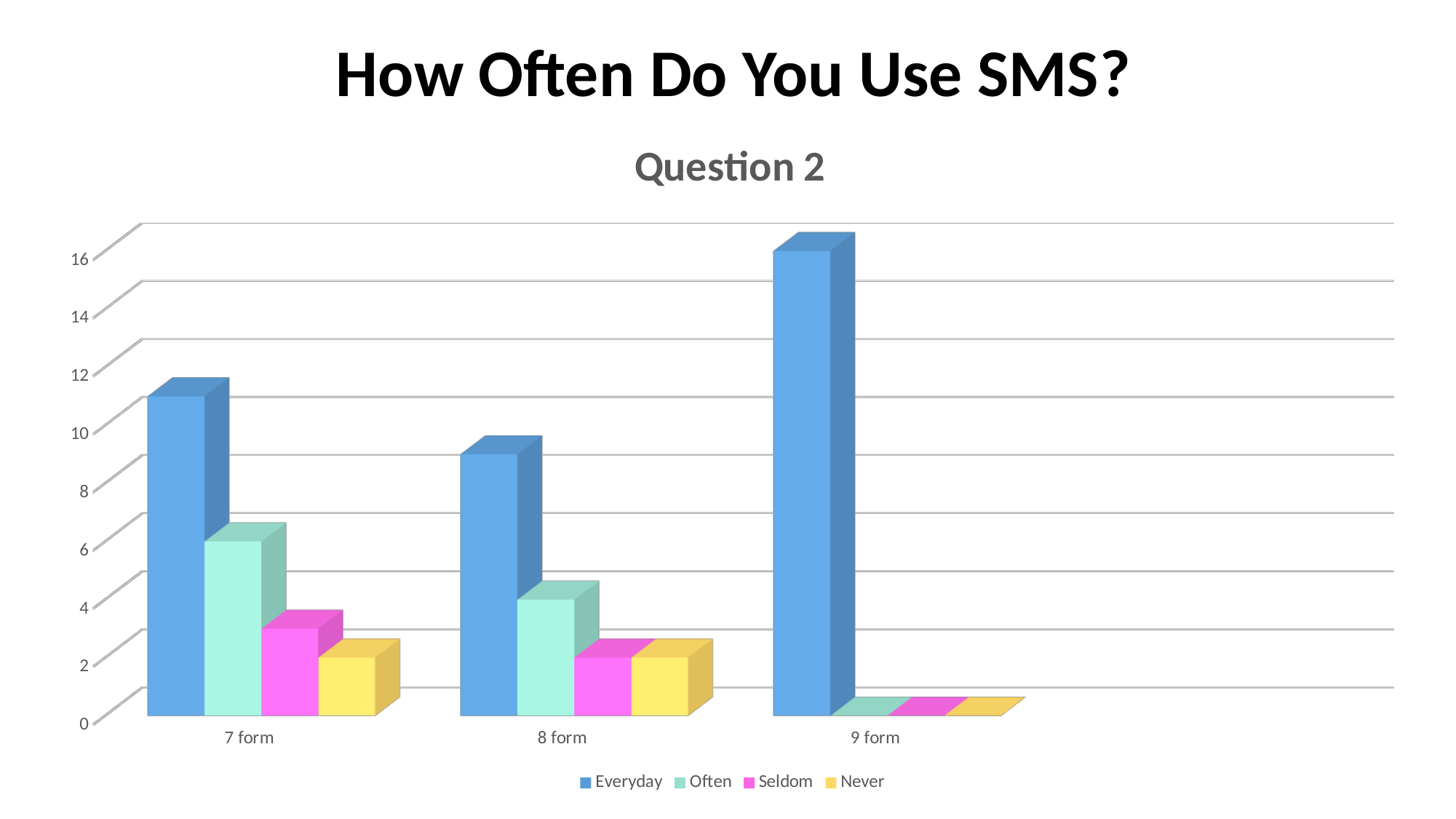
Is the Often value for 8 form greater or less than 6? less Which is larger, the Often value for 7 form or the Often value for 8 form? 7 form What is the title of the chart? Question 2 Which is larger, the Everyday value for 7 form or the Everyday value for 8 form? 7 form Is the Everyday value for 9 form greater or less than 14? greater Which category has the lowest Everyday value? 8 form Is the Often value for 7 form greater or less than 4? greater What kind of chart is shown on the slide? bar chart How many categories are shown on the x axis? 3 How many series does the legend list? 4 Which category has the highest Everyday value? 9 form